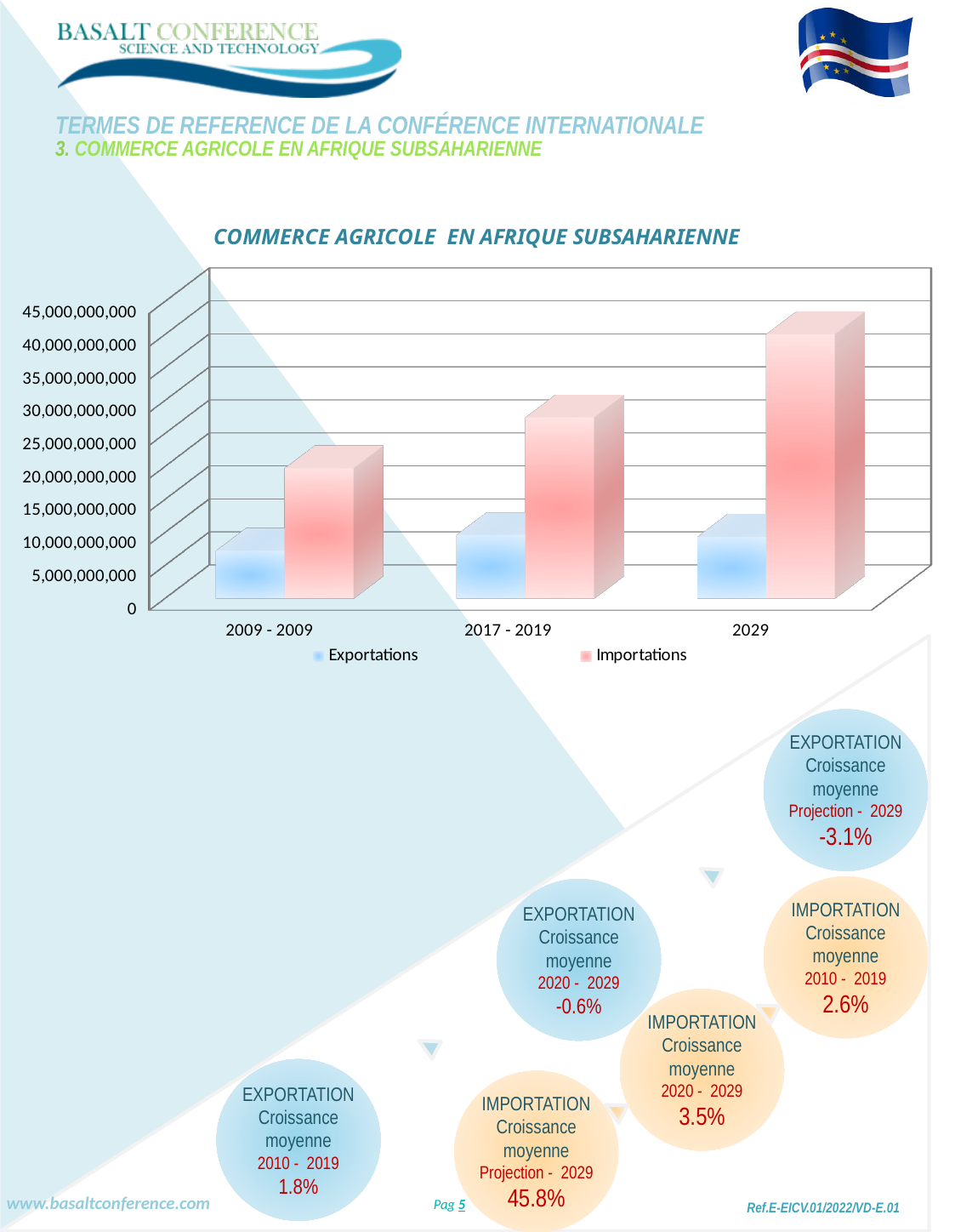
Is the Importations value for 2029 greater or less than 35,000,000,000? greater Which series is shown in red/pink in the chart? Importations Do the Importations values rise or fall across the categories from 2009 - 2009 to 2029? rise What kind of chart is shown on the slide? bar chart How many categories are shown on the x axis of the chart? 3 For which category is the Importations value highest? 2029 Is the Exportations value for 2009 - 2009 greater or less than 10,000,000,000? less How many series does the chart legend list? 2 In 2029, which is larger, Exportations or Importations? Importations For which category is the Importations value lowest? 2009 - 2009 What is the title of the chart? COMMERCE AGRICOLE EN AFRIQUE SUBSAHARIENNE Is the Importations value for 2017 - 2019 greater or less than 20,000,000,000? greater